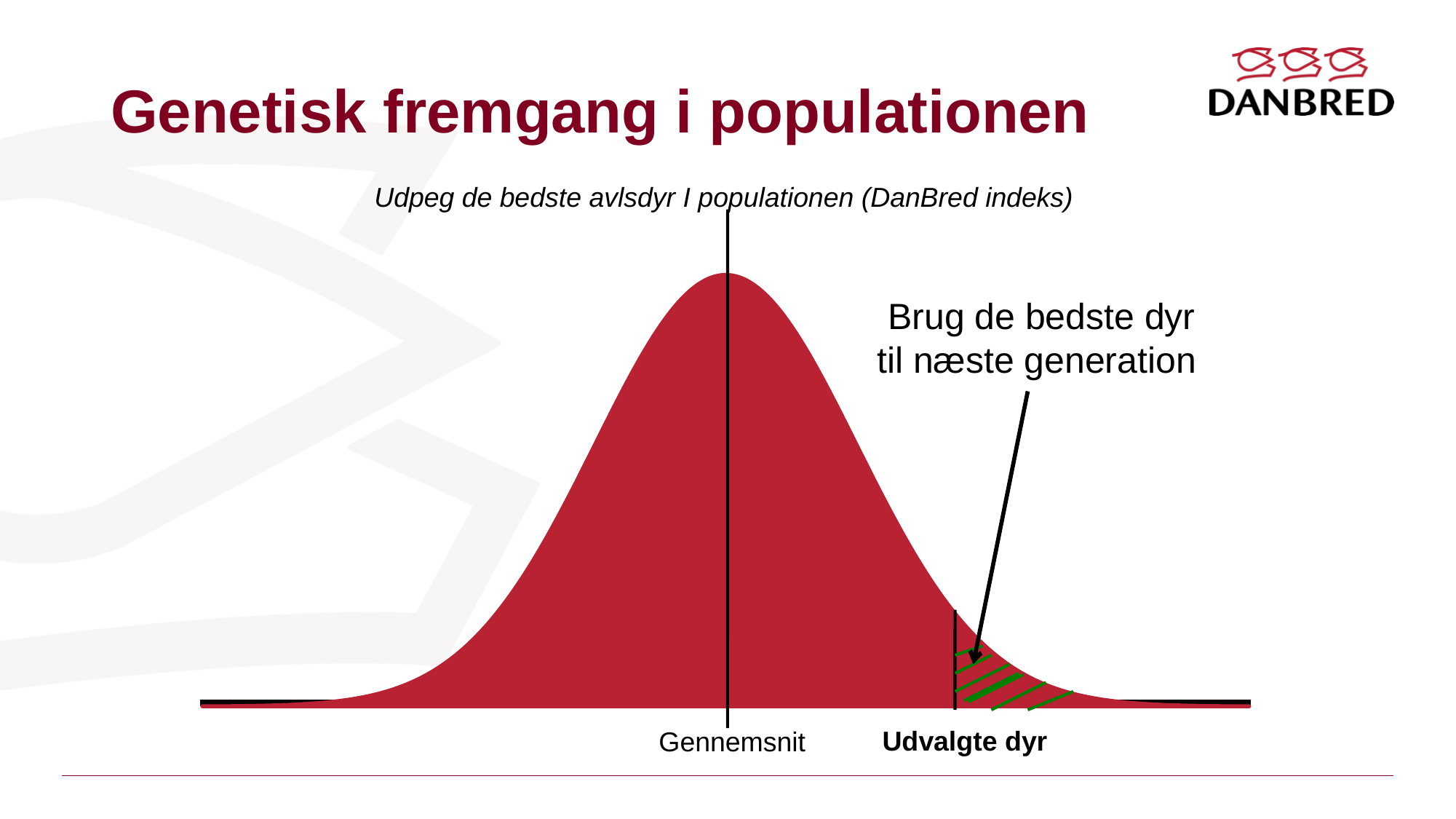
Is the curve higher at the line labelled Gennemsnit or at the line labelled Udvalgte dyr? Gennemsnit Does the curve rise or fall moving from the Gennemsnit line toward the Udvalgte dyr line? Fall What kind of chart is shown on the slide? A bell curve (normal distribution curve) Which label marks the vertical line at the peak of the curve? Gennemsnit Which label marks the hatched area in the right tail of the curve? Udvalgte dyr